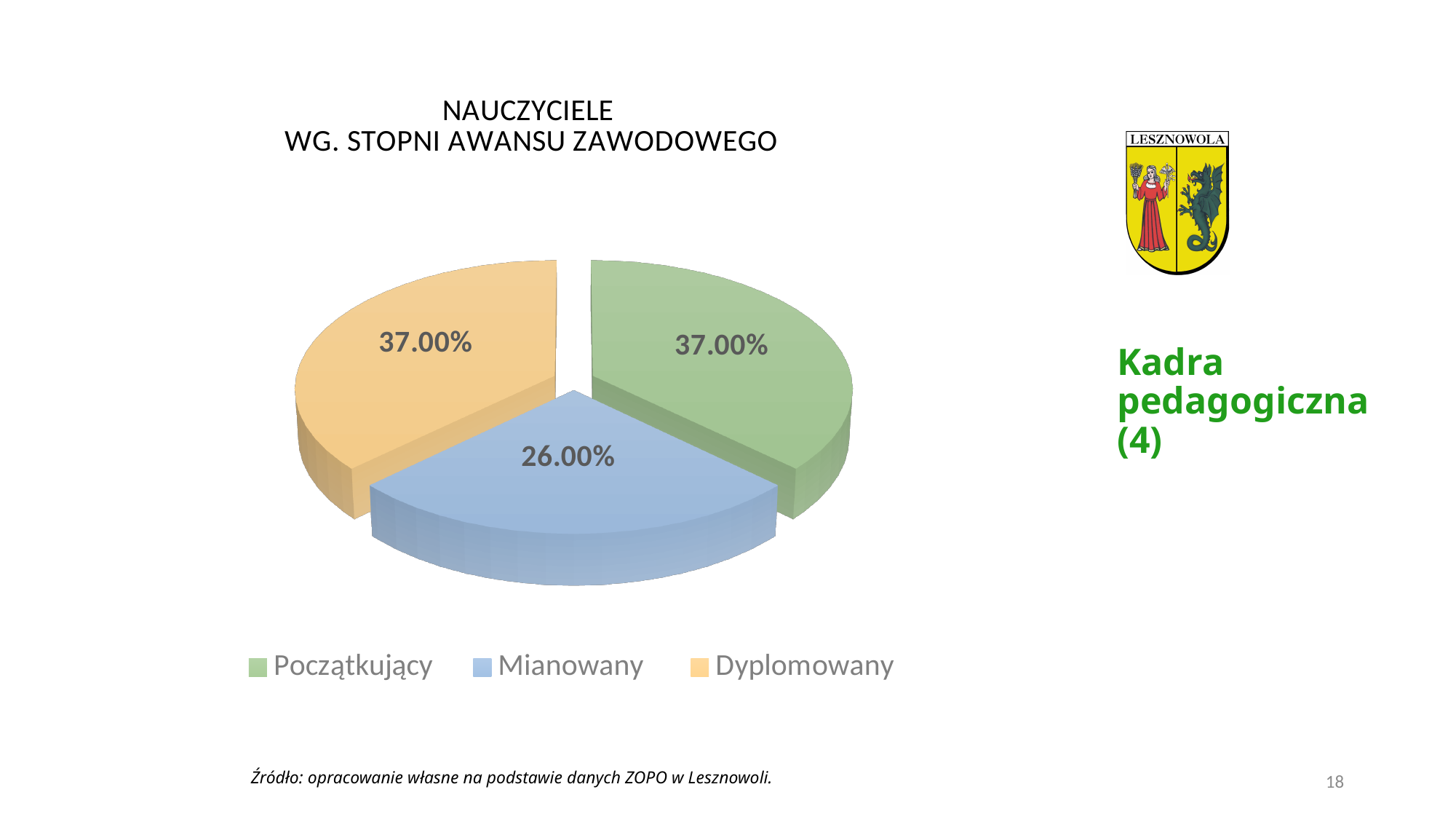
What share of the pie does Mianowany have? 26.00% Which is larger, the slice for Początkujący or the slice for Mianowany? Początkujący Which category has the smallest slice of the pie? Mianowany Which is larger, the slice for Dyplomowany or the slice for Mianowany? Dyplomowany What kind of chart is shown on the slide? Pie chart How many categories are shown in the pie chart? 3 Which colour represents Mianowany in the chart? Blue What is the title of the chart? NAUCZYCIELE WG. STOPNI AWANSU ZAWODOWEGO What is the difference between the Dyplomowany share and the Mianowany share? 11.00% What is the value shown for Dyplomowany? 37.00% What is the value shown for Początkujący? 37.00%